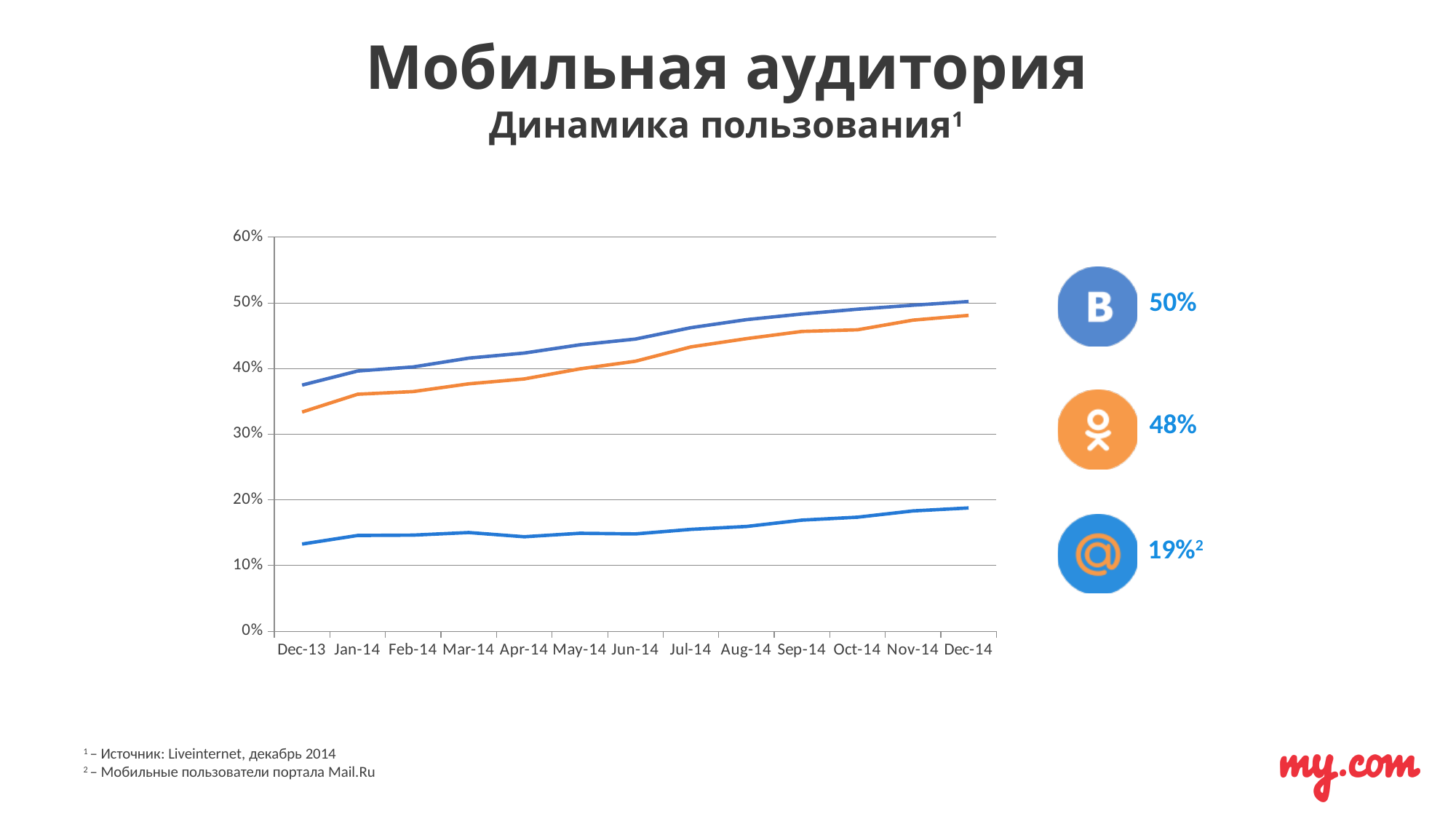
What is the value shown for the orange line at Dec-14? 48% What is the value shown for the bottom (light blue) line at Dec-14? 19% What kind of chart is shown on the slide? line chart How many lines (series) are plotted on the chart? 3 Is the value of the orange line at Dec-13 greater or less than 30%? greater How many monthly points are shown along the x axis of the chart? 13 Which line has the lowest value at Dec-14? the bottom (light blue) line, 19% What is the first month shown on the x axis of the chart? Dec-13 What is the value shown for the top (dark blue) line at Dec-14? 50% Do the values of the orange line rise or fall from Dec-13 to Dec-14? rise Is the value of the bottom (light blue) line at Dec-13 greater or less than 20%? less What is the difference between the Dec-14 values of the top line (50%) and the bottom line (19%)? 31 percentage points